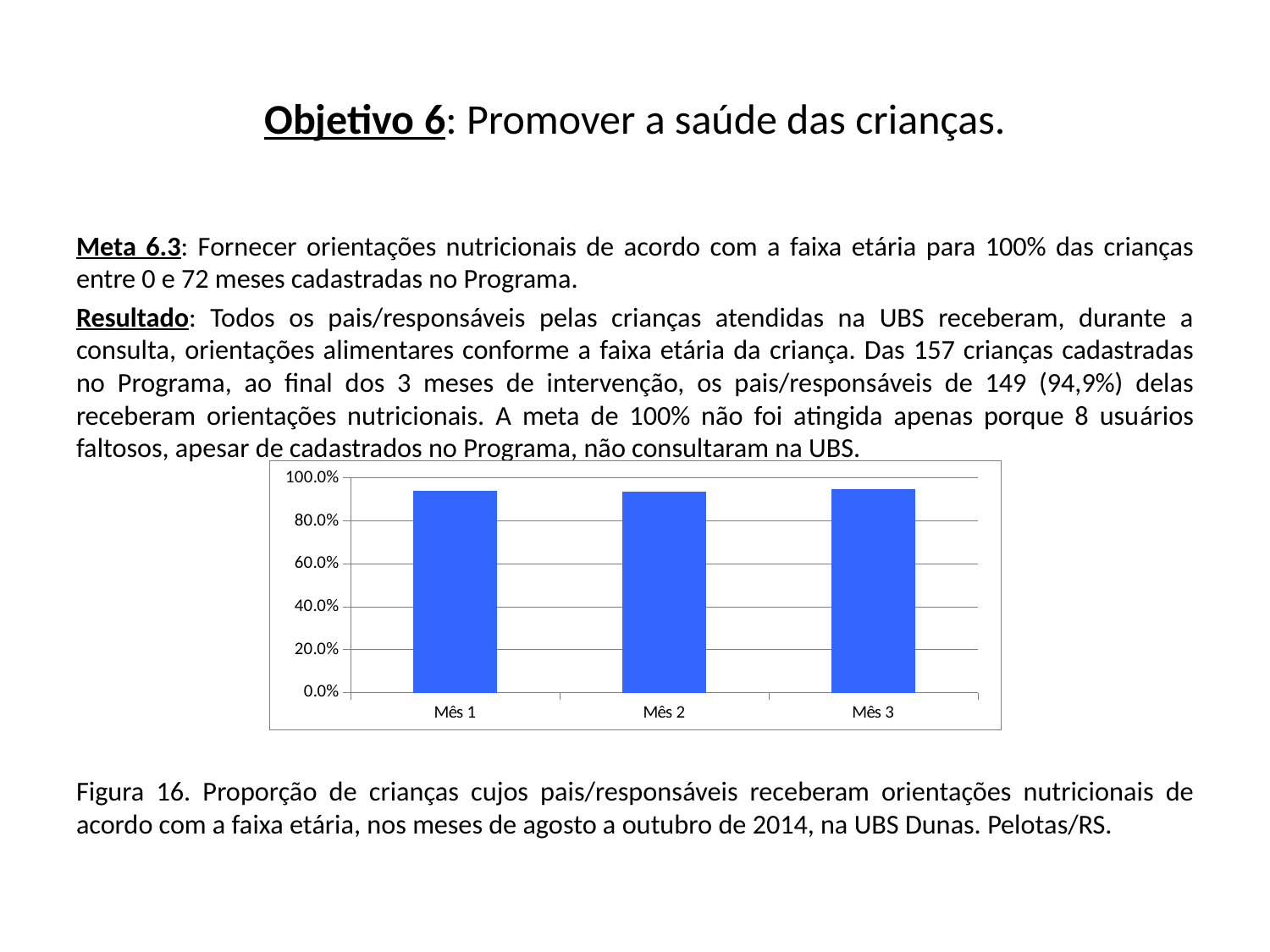
Is the value for Mês 2 greater or less than 100.0%? less Is the value for Mês 1 greater or less than 100.0%? less Is the value for Mês 3 greater or less than 60.0%? greater What is the highest tick value shown on the y axis? 100.0% What kind of chart is shown on the slide? bar chart How many categories (bars) are plotted on the chart? 3 What is the label of the first category on the x axis? Mês 1